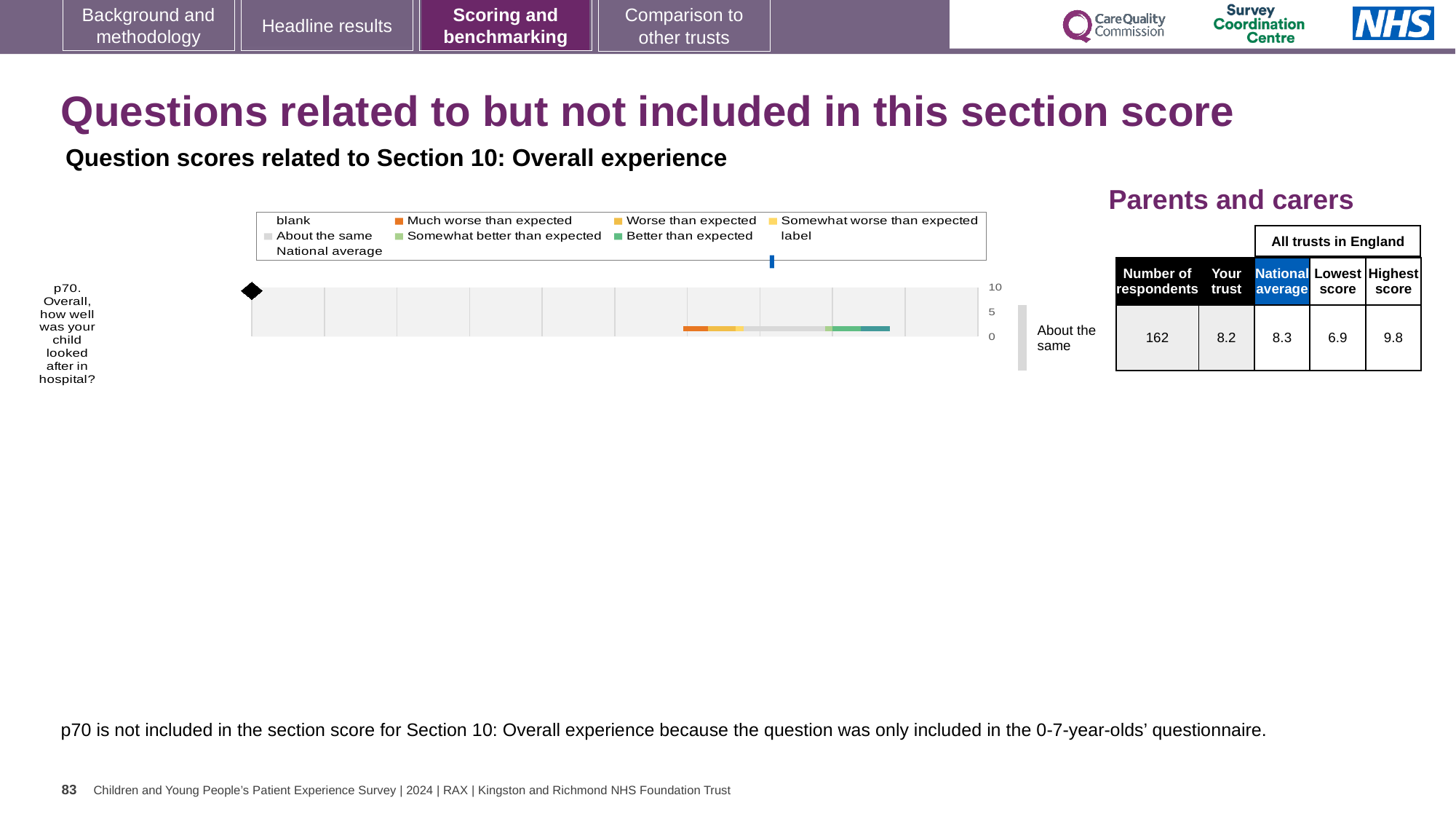
What is the difference between the highest score and the lowest score for p70? 2.9 Which benchmark category is shown next to the chart for p70? About the same What is the lowest score among all trusts in England for p70? 6.9 What kind of chart is shown for question p70? bar chart How many respondents answered p70? 162 What is the 'Your trust' score for p70? 8.2 How many survey questions are plotted in the chart? 1 Which is larger for p70, the 'Your trust' score or the national average? National average What is the highest score among all trusts in England for p70? 9.8 What is the national average score for p70? 8.3 What colour represents 'Much worse than expected' in the legend? Orange